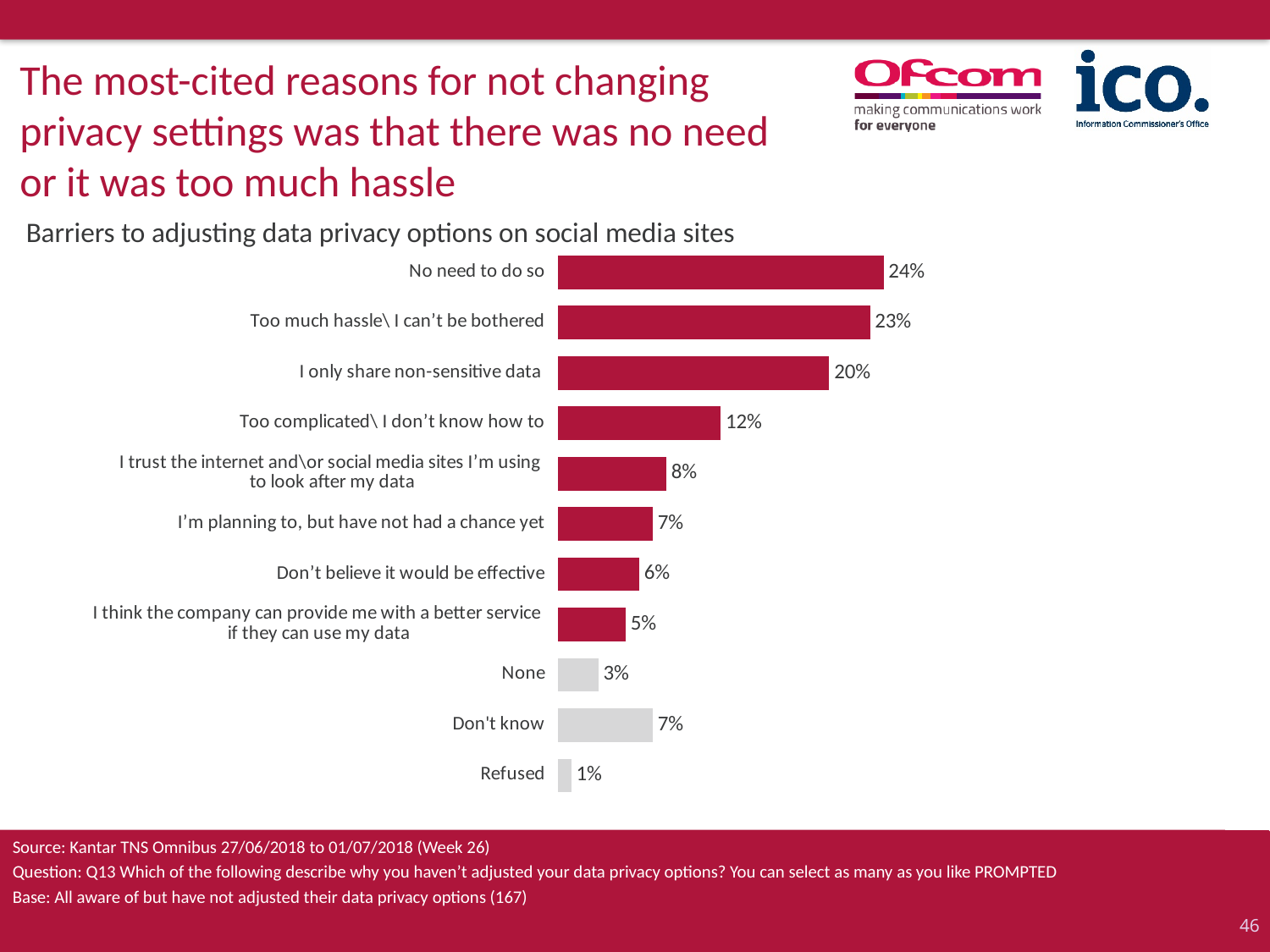
Which barrier has the highest percentage? No need to do so What percentage of respondents cited "No need to do so" as a barrier? 24% Which is larger: "Don't believe it would be effective" or "Don't know"? Don't know What is the title of the chart? Barriers to adjusting data privacy options on social media sites What is the difference between "No need to do so" and "Too much hassle\ I can't be bothered"? 1% What percentage said "Too complicated\ I don't know how to"? 12% How many categories are shown on the chart? 11 What is the difference between "I only share non-sensitive data" and "Too complicated\ I don't know how to"? 8% What is the value shown for "Refused"? 1% Which category has the lowest value on the chart? Refused What type of chart is used on this slide? Bar chart What is the value for "I only share non-sensitive data"? 20%